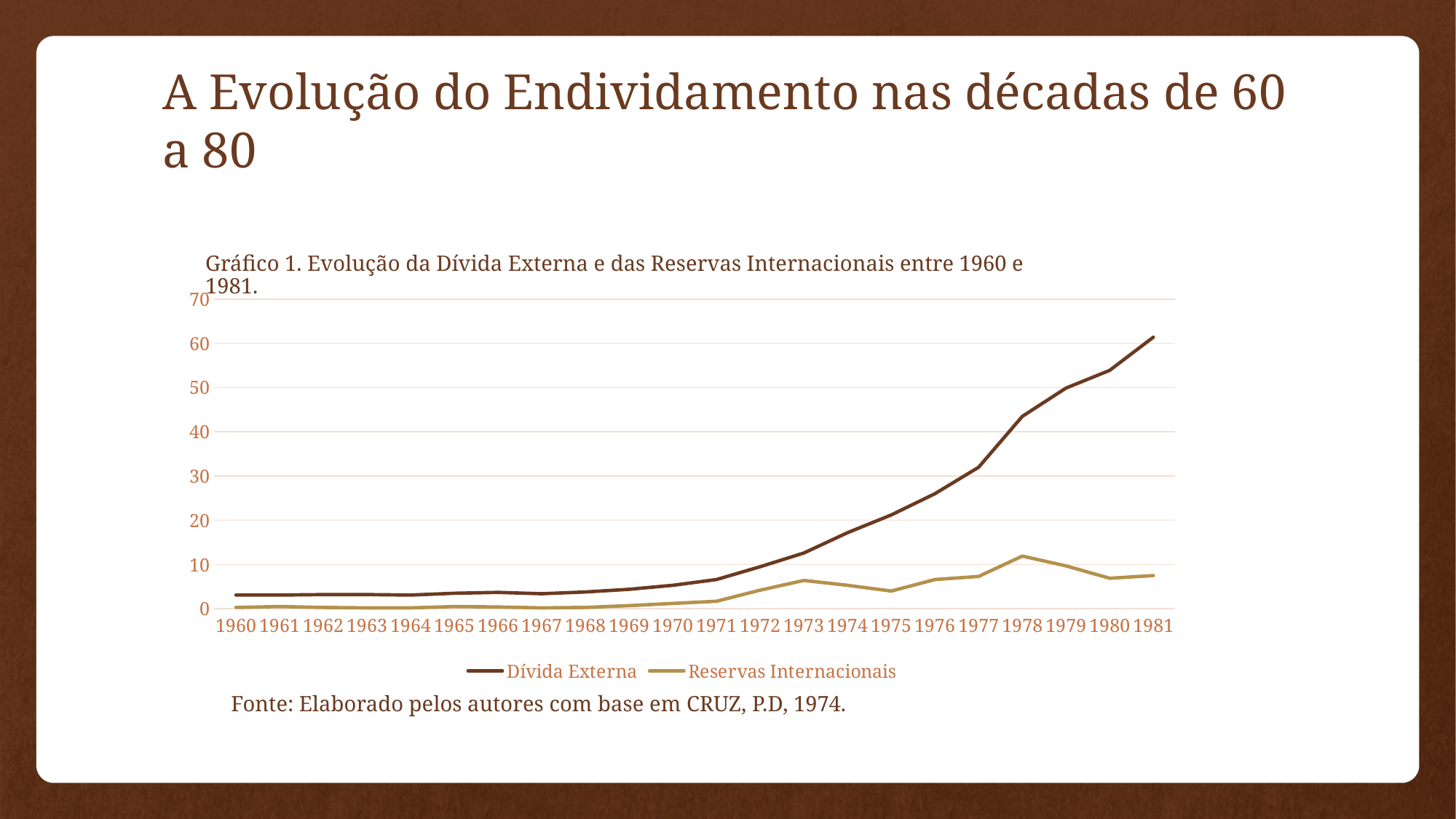
What kind of chart is shown on the slide? line chart In which year does Reservas Internacionais reach its highest value? 1978 Which two series are listed in the legend? Dívida Externa and Reservas Internacionais In 1981, which series has the larger value, Dívida Externa or Reservas Internacionais? Dívida Externa What is the title of the chart? Gráfico 1. Evolução da Dívida Externa e das Reservas Internacionais entre 1960 e 1981. Is the value for Reservas Internacionais in 1978 greater or less than 20? less How many years are plotted along the x axis? 22 How many series does the legend list? 2 In which year does Dívida Externa reach its highest value? 1981 Is the value for Dívida Externa in 1981 greater or less than 50? greater Does the Dívida Externa line rise or fall from 1960 to 1981? rise Is the value for Dívida Externa in 1973 greater or less than 20? less